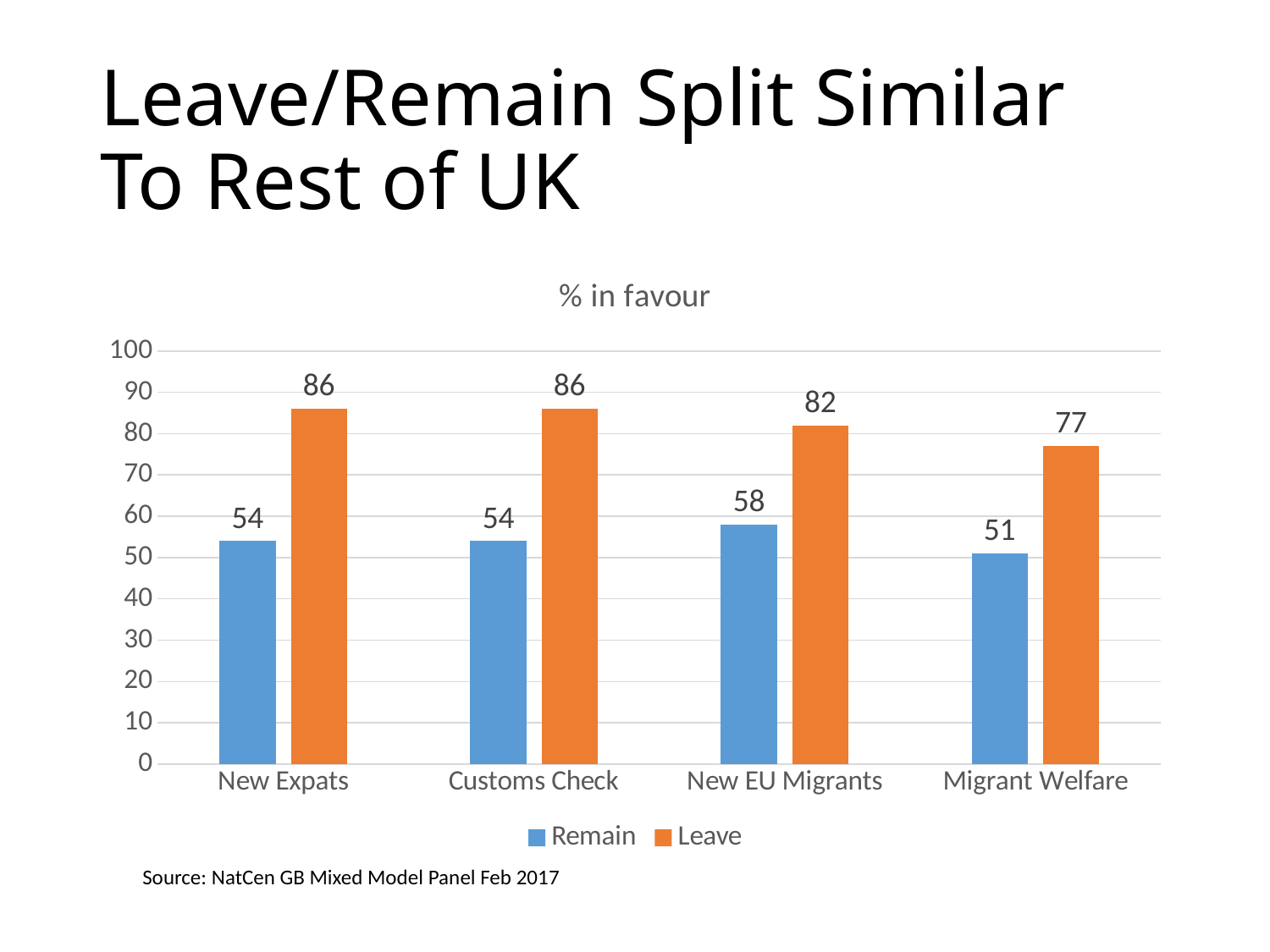
Which category has the lowest Remain value? Migrant Welfare What is the Remain value for Customs Check? 54 What kind of chart is shown on the slide? Bar chart What is the difference between the Leave values for Customs Check and Migrant Welfare? 9 How many categories are shown on the x axis? 4 What is the difference between the Leave and Remain values for New Expats? 32 What is the Remain value for New EU Migrants? 58 Which category has the highest Remain value? New EU Migrants Is the Leave value for New EU Migrants larger than the Remain value for New EU Migrants? Yes Which category has the lowest Leave value? Migrant Welfare How many series does the legend list? 2 What is the Leave value for Migrant Welfare? 77